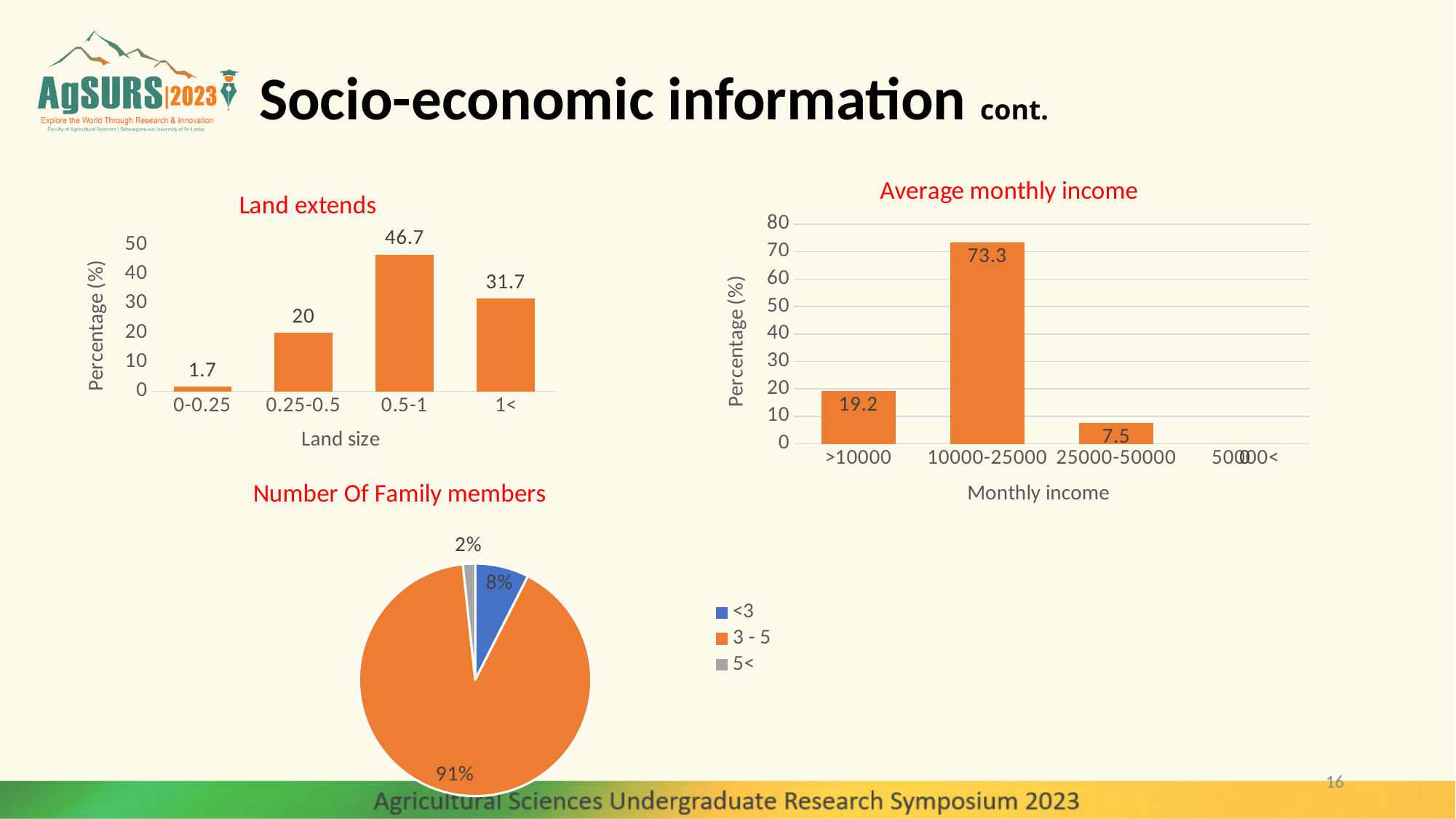
What kind of chart is the "Number Of Family members" chart? Pie chart In the "Average monthly income" chart, what is the percentage for the 25000-50000 income category? 7.5 In the "Number Of Family members" chart, how many categories does the legend list? 3 In the "Average monthly income" chart, what is the difference between the values for 10000-25000 and >10000? 54.1 In the "Land extends" chart, what is the percentage for the 0.5-1 land size category? 46.7 In the "Land extends" chart, what is the difference between the percentages for 0.5-1 and 1<? 15 In the "Land extends" chart, which land size category has the highest percentage? 0.5-1 In the "Average monthly income" chart, which is larger, the value for >10000 or the value for 25000-50000? >10000 In the "Average monthly income" chart, what is the percentage for the 10000-25000 income category? 73.3 In the "Land extends" chart, how many land size categories are shown? 4 In the "Number Of Family members" chart, what share of the pie is the 3 - 5 category? 91% In the "Land extends" chart, what is the percentage for the 0-0.25 land size category? 1.7